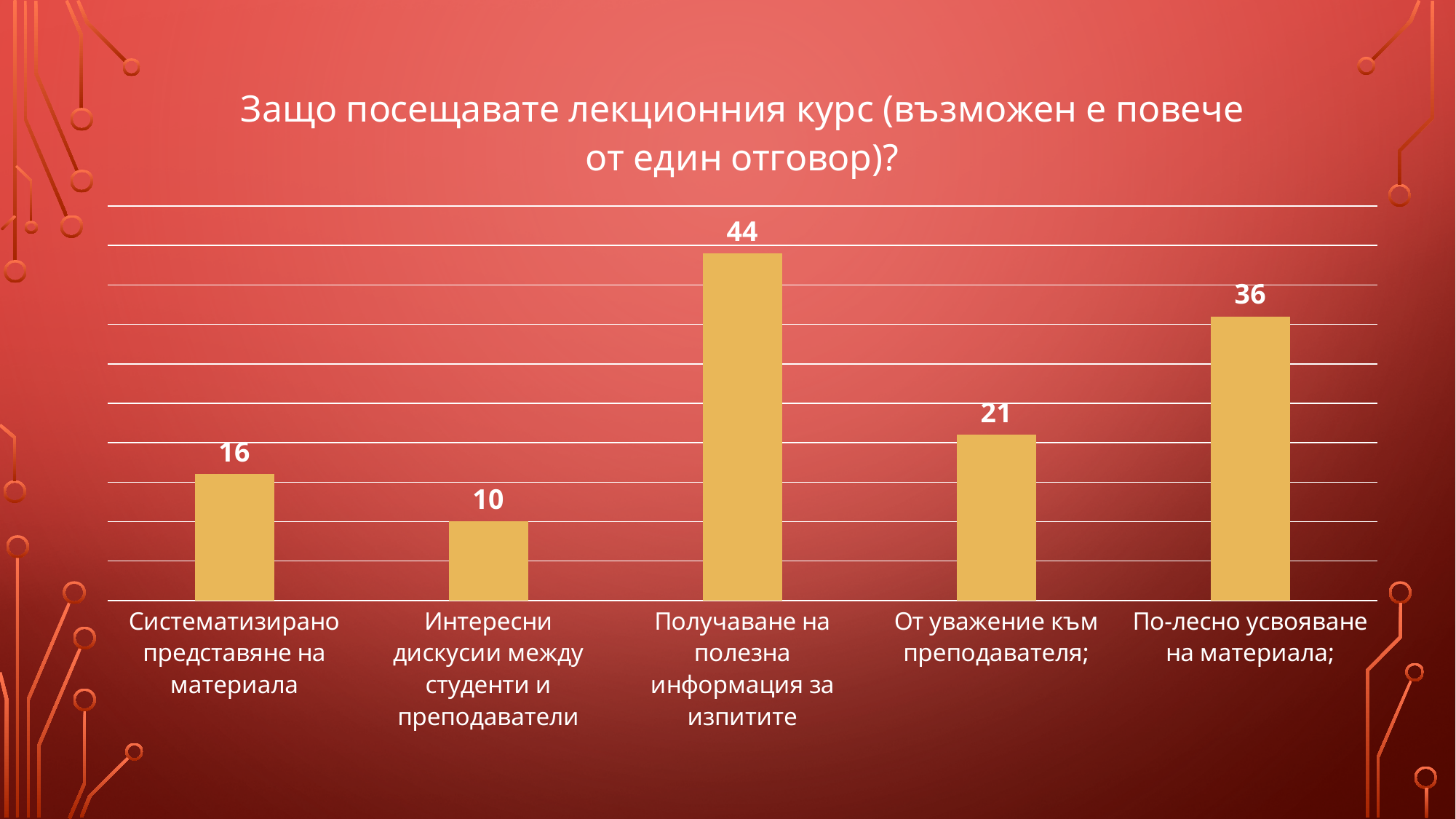
What is the value for "От уважение към преподавателя;"? 21 What is the title of the chart? Защо посещавате лекционния курс (възможен е повече от един отговор)? What is the value for "Получаване на полезна информация за изпитите"? 44 What is the difference between the values for "Получаване на полезна информация за изпитите" and "По-лесно усвояване на материала;"? 8 What is the value for "Интересни дискусии между студенти и преподаватели"? 10 What is the difference between the values for "Систематизирано представяне на материала" and "Интересни дискусии между студенти и преподаватели"? 6 What kind of chart is shown on the slide? Bar chart What is the value for "Систематизирано представяне на материала"? 16 How many categories are shown in the chart? 5 Which is larger: the value for "От уважение към преподавателя;" or the value for "Систематизирано представяне на материала"? От уважение към преподавателя; Which category has the lowest value? Интересни дискусии между студенти и преподаватели Which category has the highest value? Получаване на полезна информация за изпитите